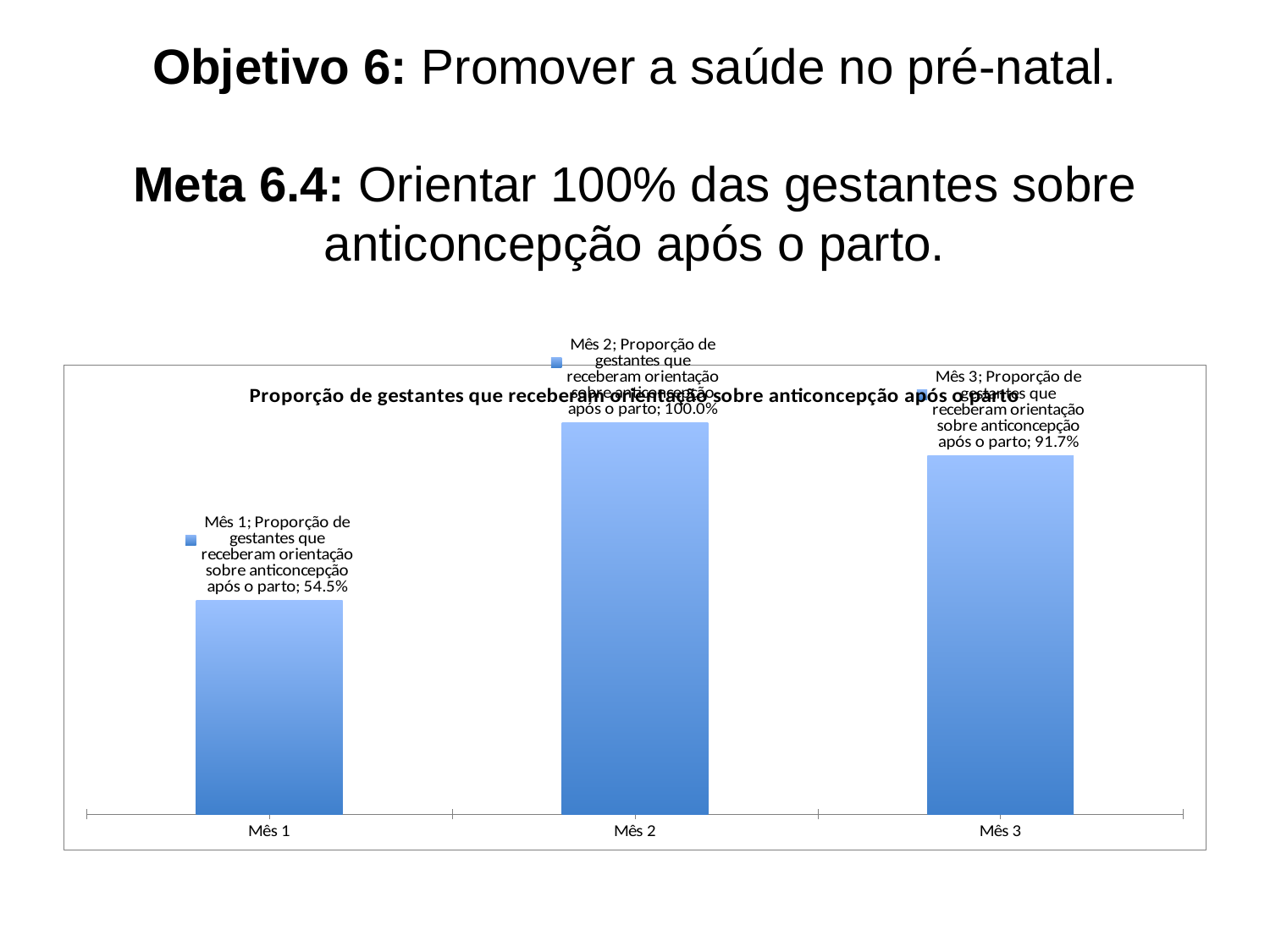
What is the value for Mês 3? 91.7% What kind of chart is shown on the slide? Bar chart Which month has the highest value? Mês 2 Which is larger, the value for Mês 3 or the value for Mês 1? Mês 3 How many months are shown on the x axis? 3 Which month has the lowest value? Mês 1 What is the title of the chart? Proporção de gestantes que receberam orientação sobre anticoncepção após o parto What is the difference between the values for Mês 2 and Mês 3? 8.3% What is the value for Mês 1? 54.5% Does the value rise or fall from Mês 2 to Mês 3? Fall What is the difference between the values for Mês 2 and Mês 1? 45.5% What is the value for Mês 2? 100.0%